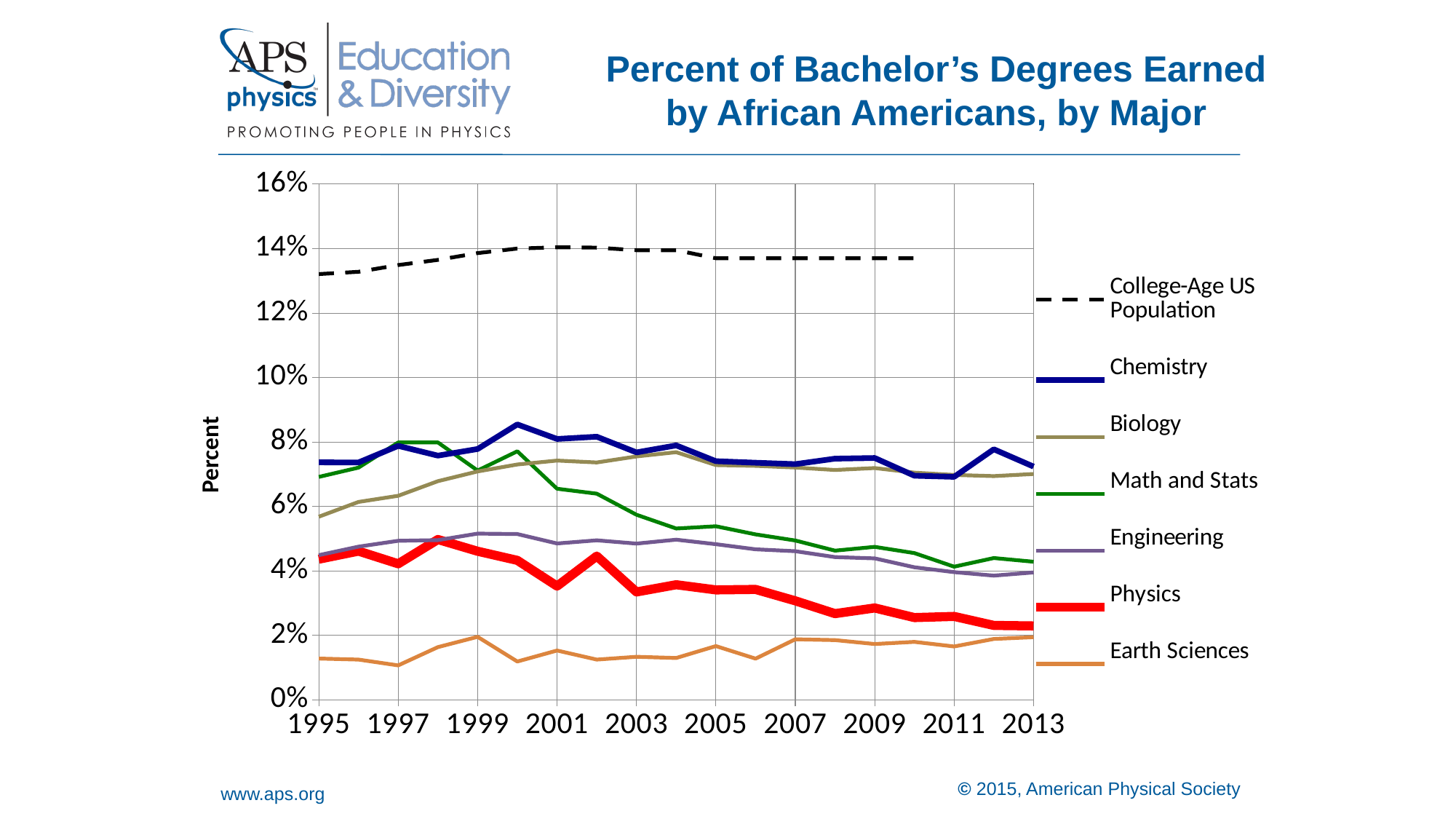
Is the value for Math and Stats in 1995 greater or less than 6%? greater Which series has the lowest value in 2013? Earth Sciences Which series is drawn with a dashed black line? College-Age US Population Is the value for Physics in 2013 greater or less than 4%? less What kind of chart is shown on the slide? Line chart What is the title of the chart? Percent of Bachelor's Degrees Earned by African Americans, by Major Is the value for Chemistry in 2000 greater or less than 8%? greater How many series does the legend list? 7 Does the Physics line rise or fall from 1995 to 2013? fall In 2013, which is larger: Chemistry or Physics? Chemistry